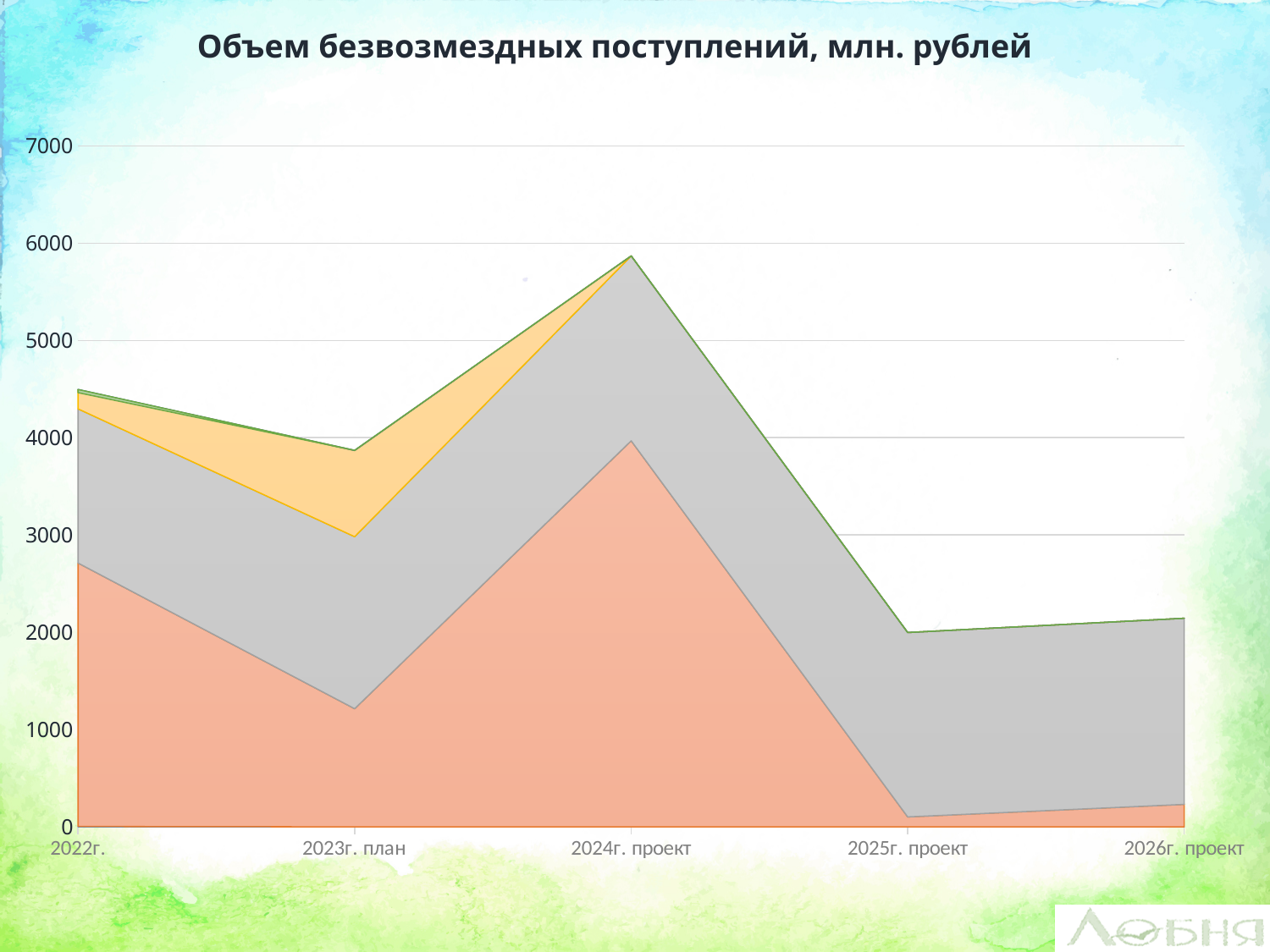
Which category has the larger total stacked value, 2022г. or 2023г. план? 2022г. Is the value of the bottom (salmon) series for 2023г. план greater or less than 1000? greater How many categories are shown on the x axis? 5 What kind of chart is shown on the slide? area chart In which category is the top of the stacked area at its lowest? 2025г. проект Is the total stacked value for 2022г. greater or less than 4000? greater In which category does the top of the stacked area reach its highest point? 2024г. проект Does the total stacked value rise or fall from 2024г. проект to 2025г. проект? fall Is the value of the bottom (salmon) series for 2022г. greater or less than 3000? less What is the title of the chart? Объем безвозмездных поступлений, млн. рублей